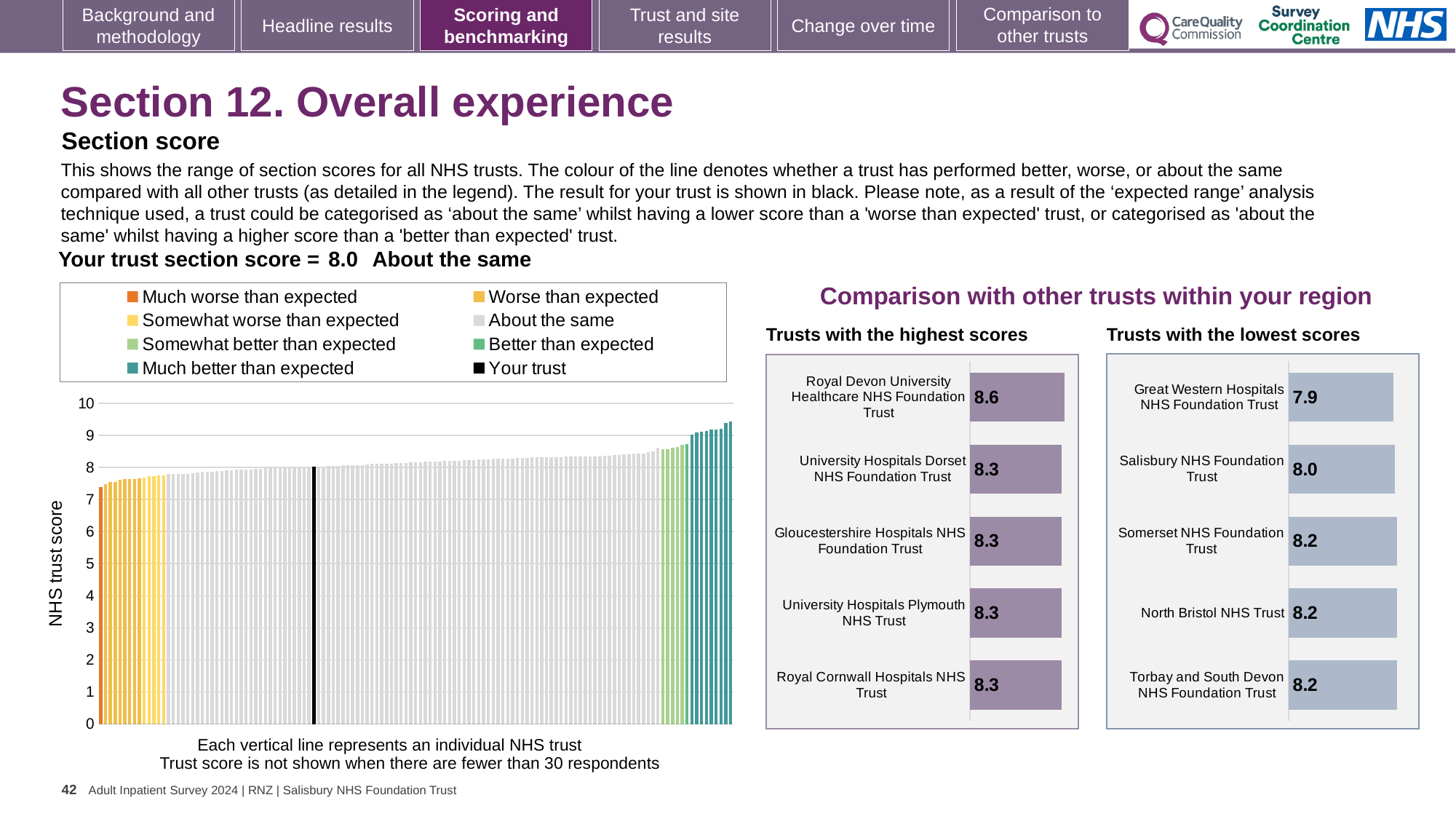
In the main section score chart on the left, do the trust scores rise or fall from left to right? Rise In the 'Trusts with the lowest scores' chart, which trust has the lowest score? Great Western Hospitals NHS Foundation Trust In the 'Trusts with the highest scores' chart, what is the difference between the scores of Royal Devon University Healthcare NHS Foundation Trust and University Hospitals Dorset NHS Foundation Trust? 0.3 What kind of chart is the main section score chart on the left of the slide? Bar chart In the 'Trusts with the lowest scores' chart, what is the score for Great Western Hospitals NHS Foundation Trust? 7.9 How many trusts are shown in the 'Trusts with the highest scores' chart? 5 In the 'Trusts with the highest scores' chart, what is the score for Royal Devon University Healthcare NHS Foundation Trust? 8.6 Which has the higher score: Royal Devon University Healthcare NHS Foundation Trust in the highest scores chart, or Torbay and South Devon NHS Foundation Trust in the lowest scores chart? Royal Devon University Healthcare NHS Foundation Trust In the 'Trusts with the lowest scores' chart, what is the score for Salisbury NHS Foundation Trust? 8.0 In the 'Trusts with the lowest scores' chart, what is the difference between the scores of Somerset NHS Foundation Trust and Great Western Hospitals NHS Foundation Trust? 0.3 In the 'Trusts with the highest scores' chart, which trust has the highest score? Royal Devon University Healthcare NHS Foundation Trust How many entries does the legend of the main section score chart on the left list? 8